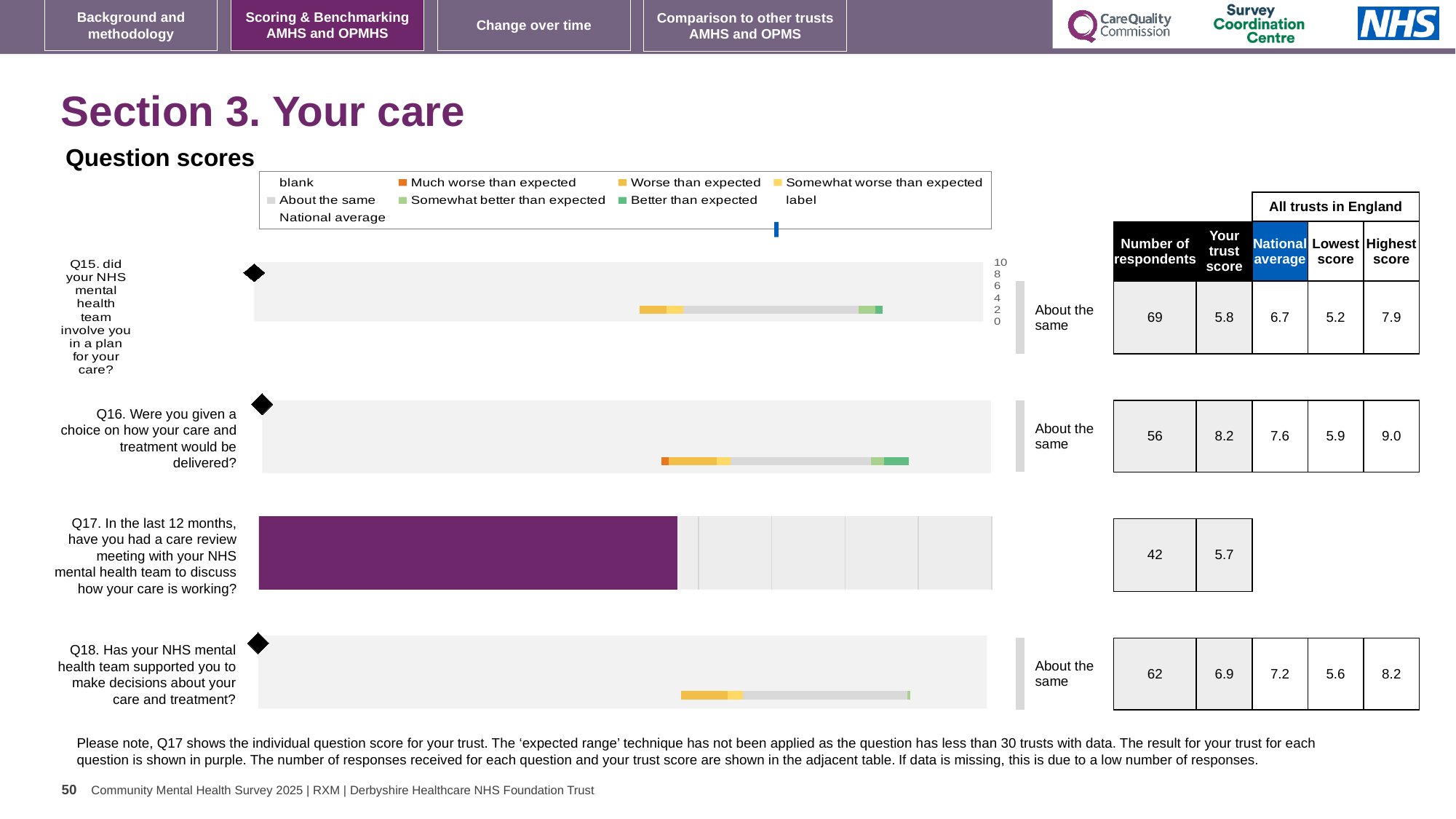
What kind of chart is used to show the question scores on this slide? bar chart What is the difference between the trust score and the national average for Q16? 0.6 Which question has the lowest trust score? Q17 What is the trust score for Q16 (Were you given a choice on how your care and treatment would be delivered)? 8.2 How many respondents answered Q17? 42 What colour is the bar for Q17? purple What is the highest score across all trusts in England for Q18? 8.2 Which question has the highest trust score? Q16 For Q18, which is larger: the trust score or the national average? national average How many questions (Q15 to Q18) are plotted on the slide? 4 What benchmark label is shown next to the Q15 chart? About the same What is the national average for Q15 (did your NHS mental health team involve you in a plan for your care)? 6.7